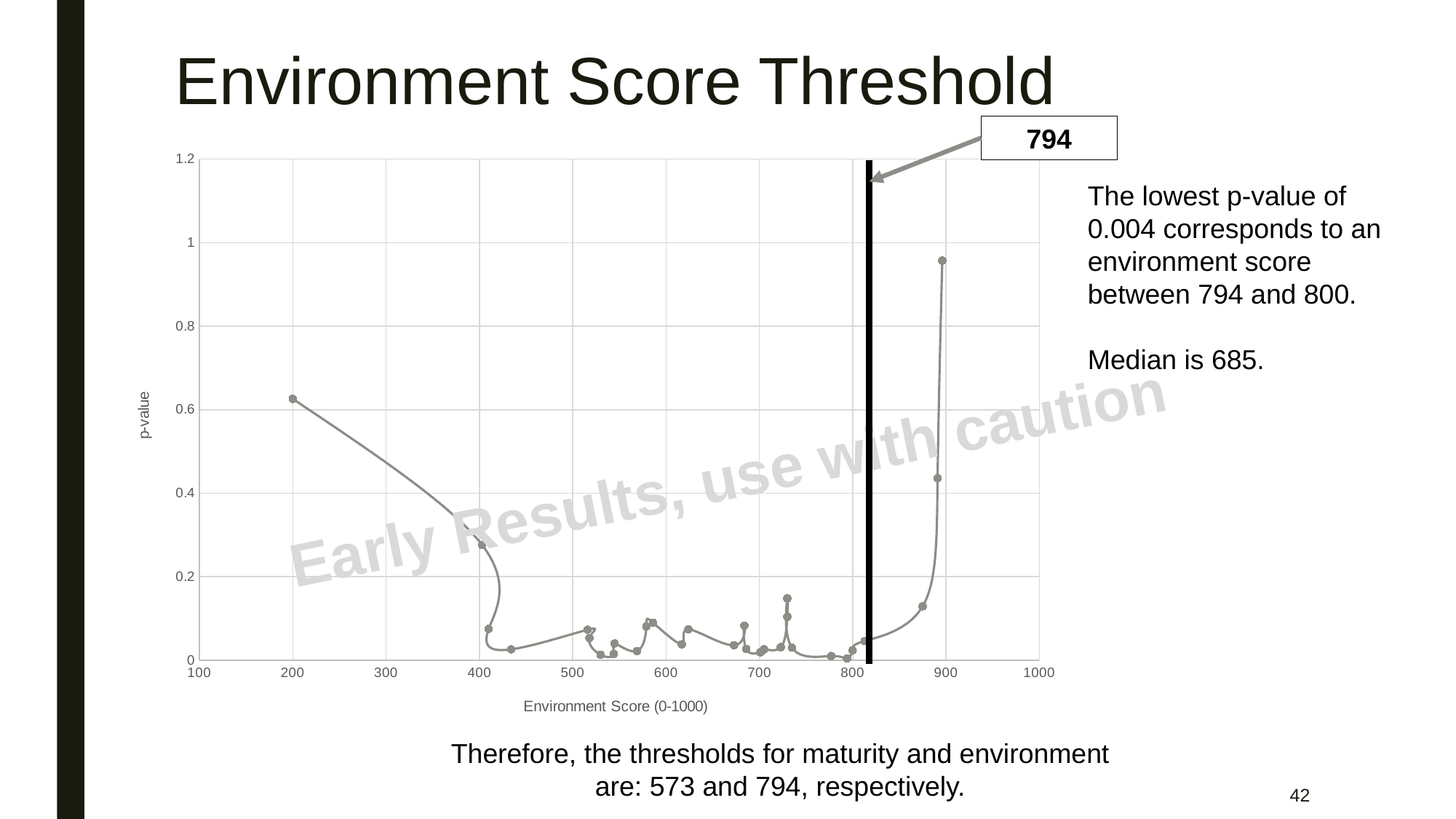
Does the p-value rise or fall as the environment score increases from 800 to 900? rise Is the p-value at an environment score of 400 greater or less than 0.4? less What kind of chart is shown on the slide? line chart According to the slide text, what is the lowest p-value in the chart? 0.004 Is the p-value at an environment score of 200 greater or less than 0.4? greater Is the p-value at an environment score of about 900 greater or less than 0.8? greater Which has the higher p-value: the point at an environment score of 200 or the point at about 900? the point at about 900 What environment score value is marked by the vertical line annotation on the chart? 794 What is the label of the x axis of the chart? Environment Score (0-1000) What is the label of the y axis of the chart? p-value Does the p-value rise or fall as the environment score increases from 200 to 400? fall